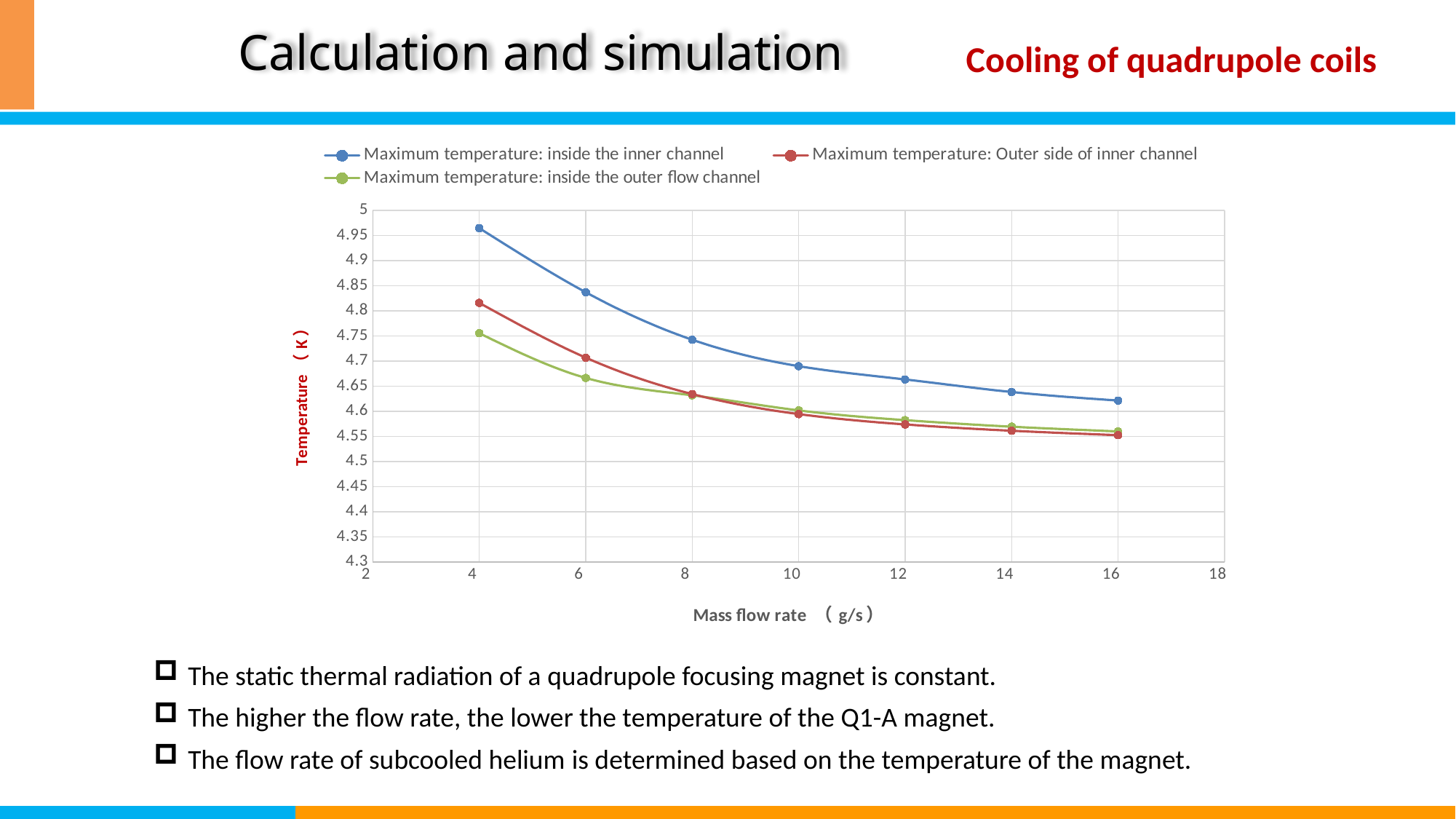
At 16 g/s, which is larger: 'Maximum temperature: inside the inner channel' or 'Maximum temperature: Outer side of inner channel'? Maximum temperature: inside the inner channel Which series has the lowest temperature at a mass flow rate of 4 g/s? Maximum temperature: inside the outer flow channel As the mass flow rate increases, do the temperatures rise or fall? fall What is the title of the x axis? Mass flow rate (g/s) Is the value for 'Maximum temperature: inside the inner channel' at 8 g/s greater or less than 4.7? greater Is the value for 'Maximum temperature: inside the outer flow channel' at 16 g/s greater or less than 4.6? less How many data points are plotted for the 'Maximum temperature: inside the inner channel' series? 7 What kind of chart is shown on the slide? line chart Which series has the highest temperature across the whole range of mass flow rates? Maximum temperature: inside the inner channel Is the value for 'Maximum temperature: inside the inner channel' at 4 g/s greater or less than 4.9? greater At 6 g/s, which is larger: 'Maximum temperature: Outer side of inner channel' or 'Maximum temperature: inside the outer flow channel'? Maximum temperature: Outer side of inner channel How many series does the legend list? 3